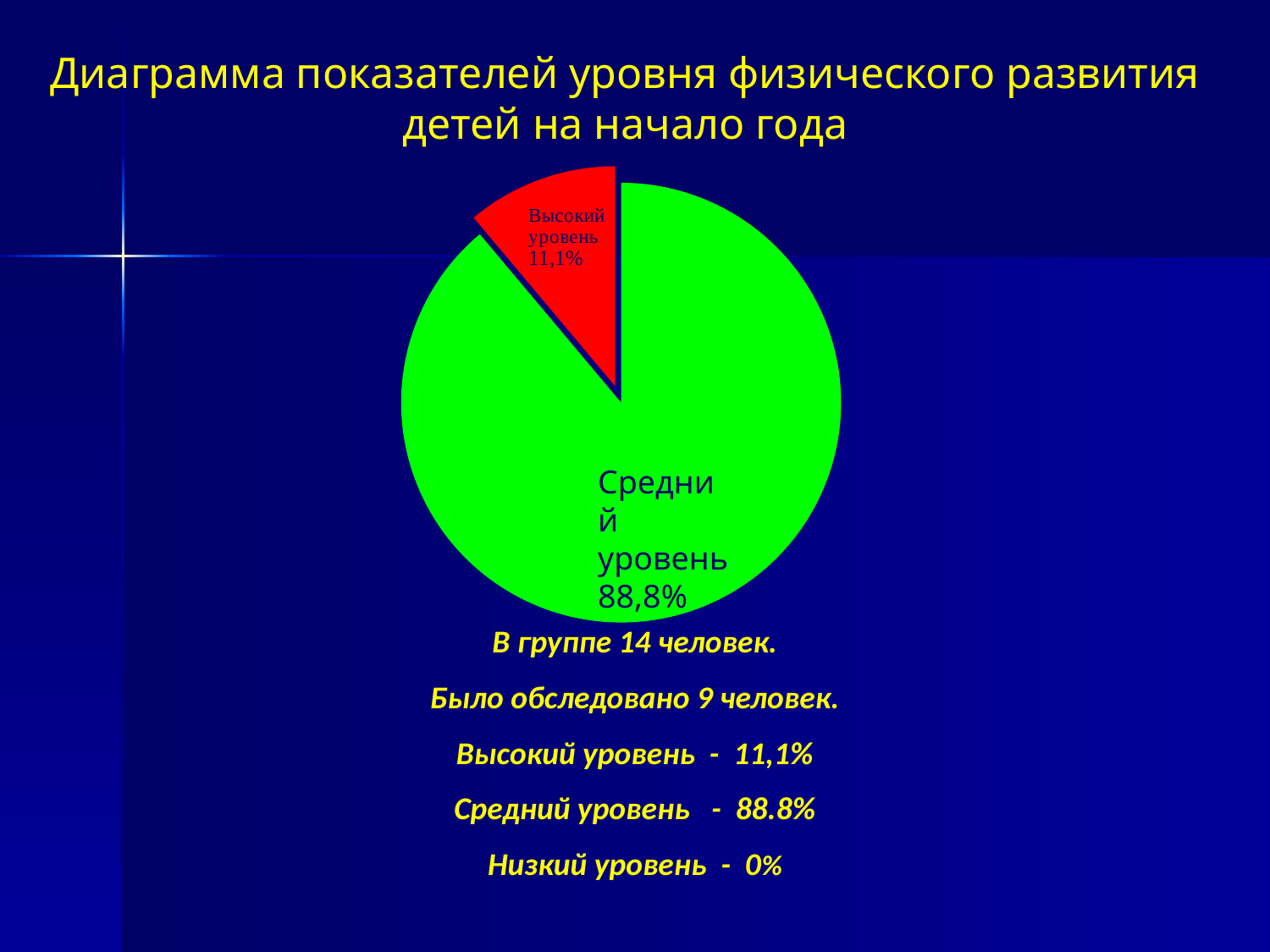
What is the difference between the Средний уровень and Высокий уровень values in the pie chart? 77,7% Which slice of the pie chart is the smallest? Высокий уровень What is the value for Средний уровень in the pie chart? 88,8% What colour is the Высокий уровень slice in the pie chart? red What is the value for Высокий уровень in the pie chart? 11,1% Which slice of the pie chart is the largest? Средний уровень What share of the pie does the Высокий уровень slice represent? 11,1% Which is larger in the pie chart: Высокий уровень or Средний уровень? Средний уровень What colour is the Средний уровень slice in the pie chart? green What kind of chart is shown on the slide? pie chart How many slices are shown in the pie chart? 2